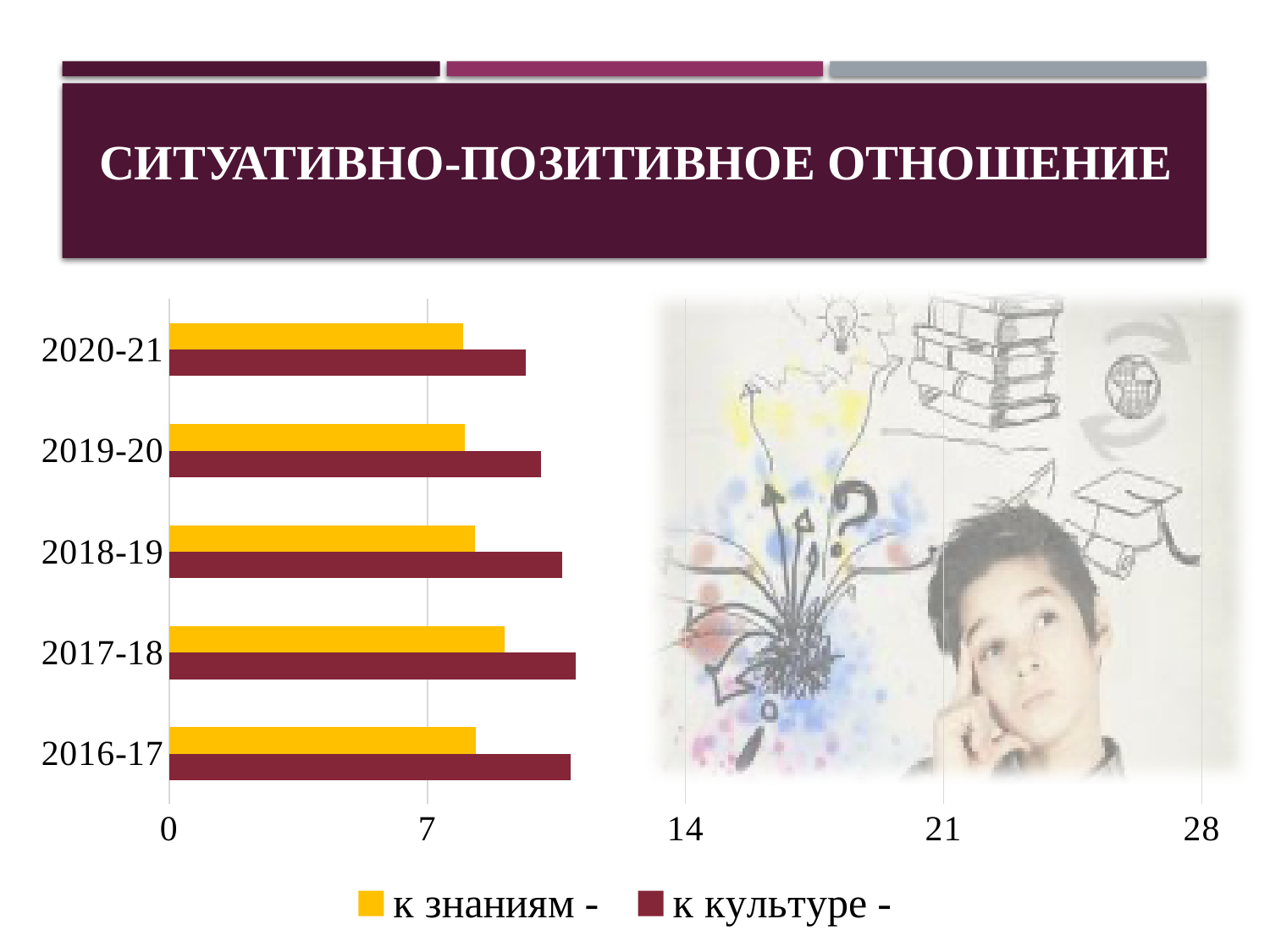
Is the value for "к знаниям -" in 2017-18 greater or less than 7? greater In which school year is the value for "к знаниям -" the highest? 2017-18 What kind of chart is shown on the slide? bar chart How many series does the chart legend list? 2 Which series has the larger value for 2016-17, "к знаниям -" or "к культуре -"? к культуре - Is the value for "к знаниям -" in 2019-20 greater or less than 14? less Which series has the larger value for 2020-21, "к знаниям -" or "к культуре -"? к культуре - How many categories (school years) are shown on the chart? 5 What is the title of the slide containing the chart? СИТУАТИВНО-ПОЗИТИВНОЕ ОТНОШЕНИЕ Do the values for "к культуре -" rise or fall from 2017-18 to 2020-21? fall Is the value for "к культуре -" in 2018-19 greater or less than 14? less Which series is shown in yellow in the chart legend? к знаниям -